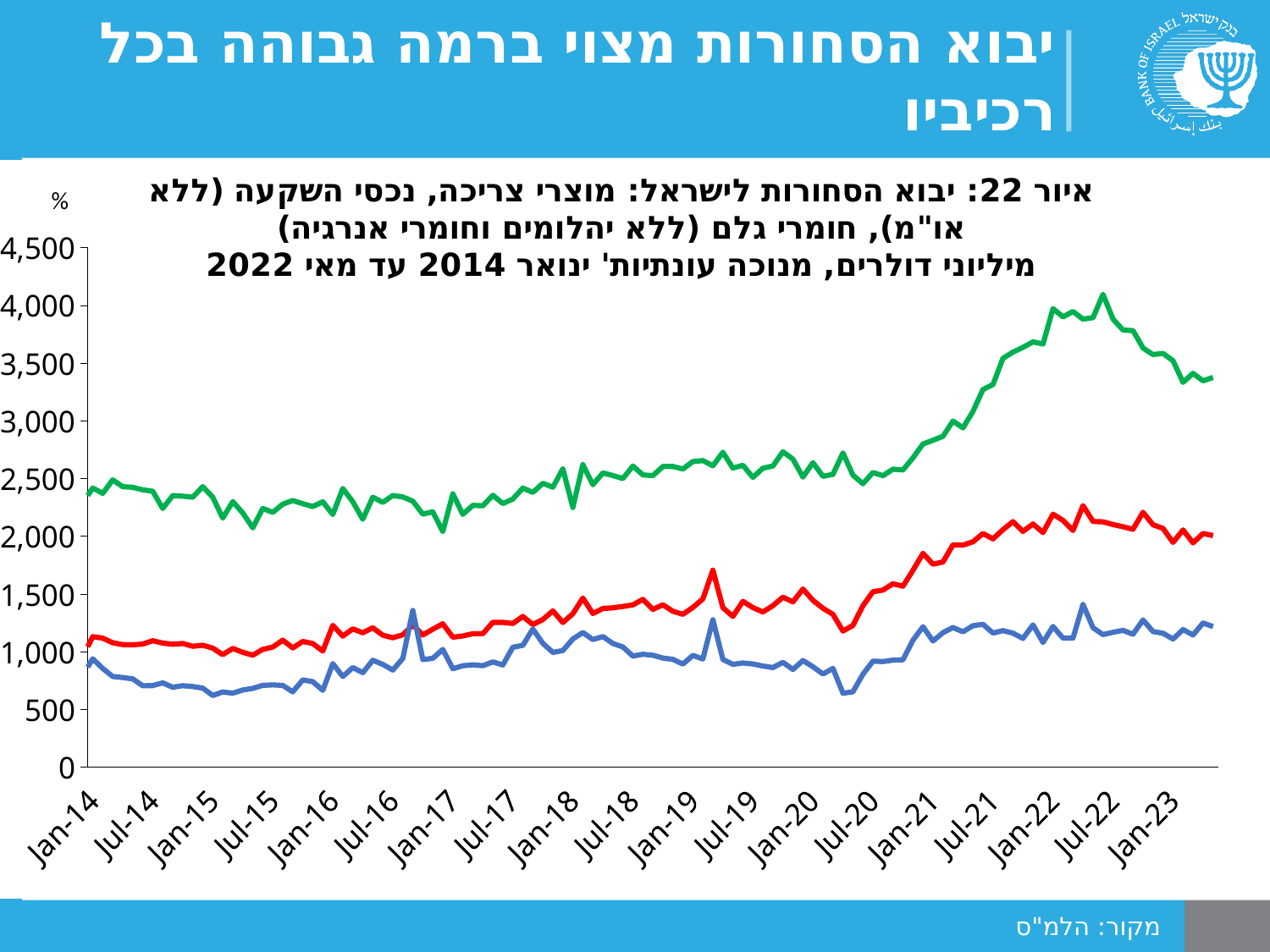
Is the value of the blue line at Jul-20 greater or less than 1,000? less Is the value of the green line at Jan-14 greater or less than 2,000? greater How many tick labels are shown on the x axis of the chart? 19 Does the green line overall rise or fall from Jan-14 to Jan-23? rise Is the value of the blue line at Jan-14 greater or less than 1,000? less How many lines are plotted on the chart? 3 What is the highest value labelled on the y axis of the chart? 4,500 What kind of chart is shown on the slide? line chart Which line is highest across the whole period: the green, red or blue line? green